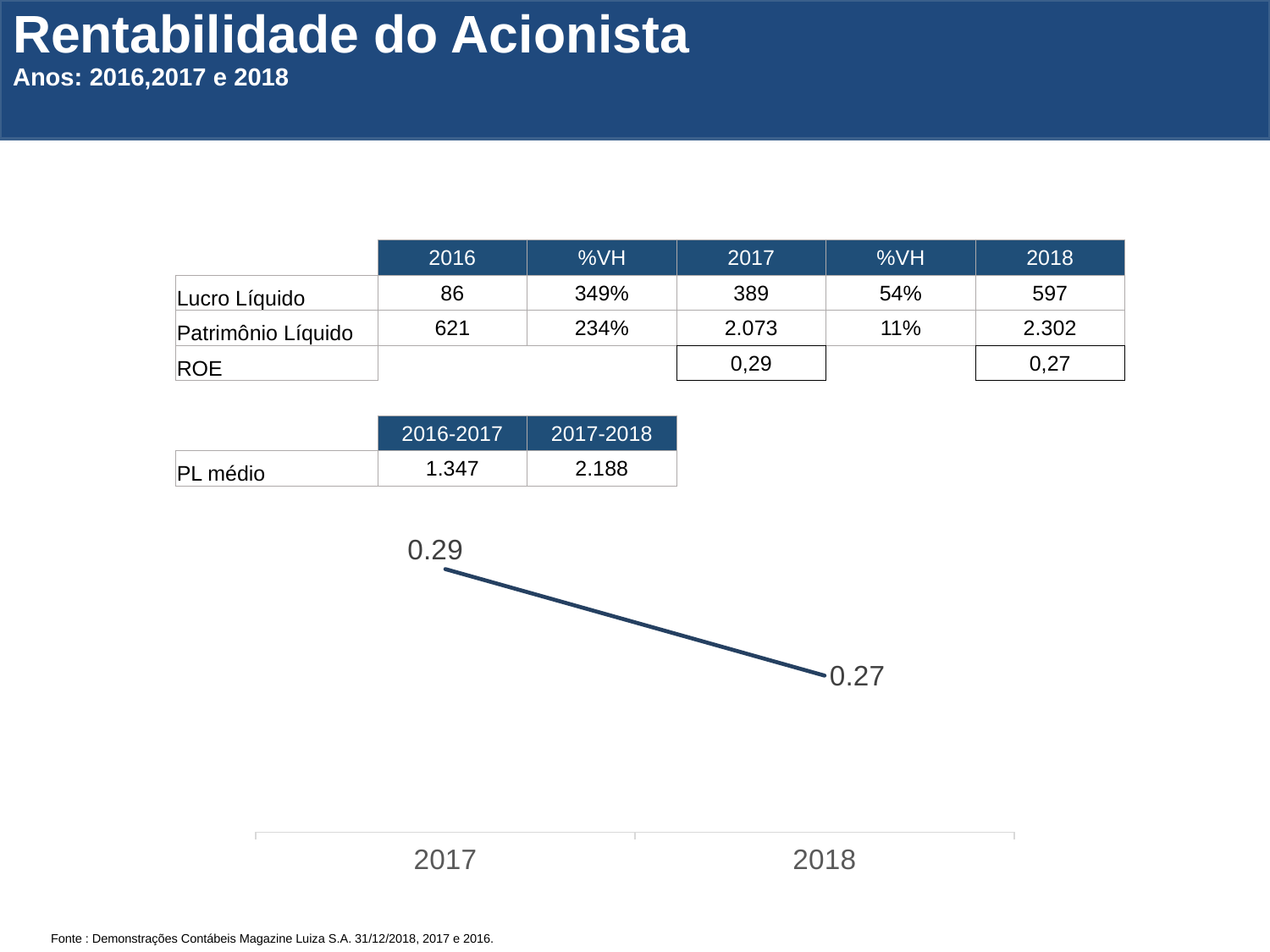
What is the value plotted for 2017 in the line chart? 0.29 What is the difference between the 2017 and 2018 values in the line chart? 0.02 What are the two categories shown on the x axis of the line chart? 2017 and 2018 How many data points are plotted in the line chart? 2 Which year has the highest value in the line chart? 2017 What kind of chart is shown on the slide? line chart Does the value in the line chart rise or fall from 2017 to 2018? fall What is the value plotted for 2018 in the line chart? 0.27 In the line chart, is the value for 2017 larger or smaller than the value for 2018? larger Which year has the lowest value in the line chart? 2018